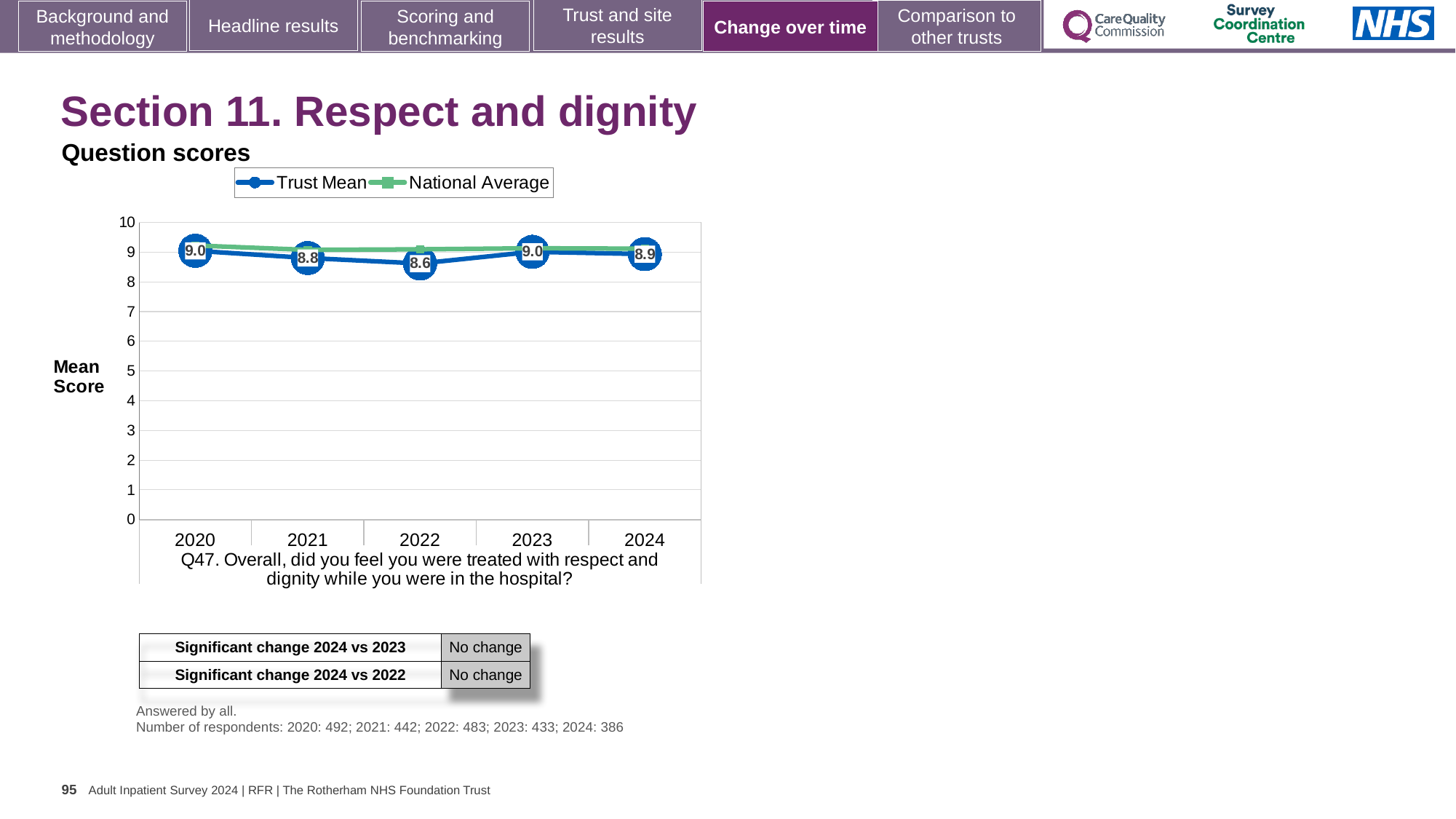
How many series does the legend list? 2 What kind of chart is shown on the slide? Line chart What is the Trust Mean score for 2024? 8.9 What is the Trust Mean score for 2022? 8.6 What is the label of the y axis? Mean Score What is the difference between the Trust Mean scores for 2023 and 2022? 0.4 Is the National Average value for 2022 greater or less than 8? greater Does the Trust Mean score rise or fall from 2020 to 2022? Fall In which year is the Trust Mean score lowest? 2022 Which year has the higher Trust Mean score, 2021 or 2022? 2021 How many years are plotted on the x axis? 5 What is the Trust Mean score for 2020? 9.0